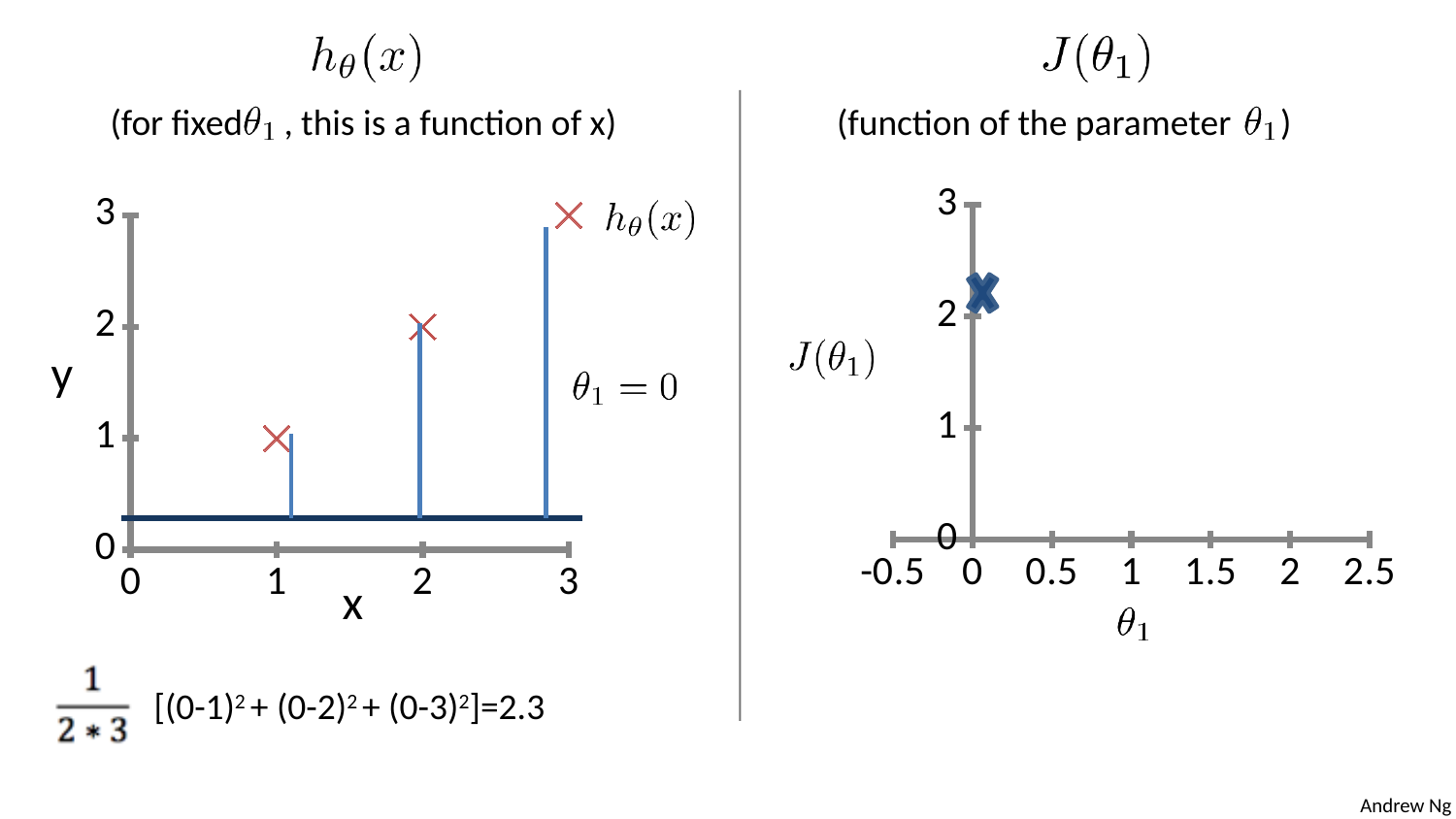
On the left chart (h_θ(x)), do the y values of the data points rise or fall as x increases? rise On the left chart (h_θ(x)), which x value has the lowest y value among the plotted points? 1 On the right chart (J(θ1)), is the J value of the plotted point greater or less than 3? less On the right chart (J(θ1)), how many points are plotted? 1 On the left chart (h_θ(x)), what is the y value of the data point at x = 3? 3 On the left chart (h_θ(x)), what is the difference between the y values at x = 3 and x = 1? 2 On the left chart (h_θ(x)), what is the y value of the data point at x = 2? 2 On the left chart (h_θ(x)), which x value has the highest y value among the plotted points? 3 On the right chart (J(θ1)), what is the label on the horizontal axis? θ1 On the right chart (J(θ1)), at what θ1 value is the plotted point located? 0 On the left chart (h_θ(x)), how many red X data points are plotted? 3 On the left chart (h_θ(x)), what value of θ1 is used for the plotted hypothesis line? 0